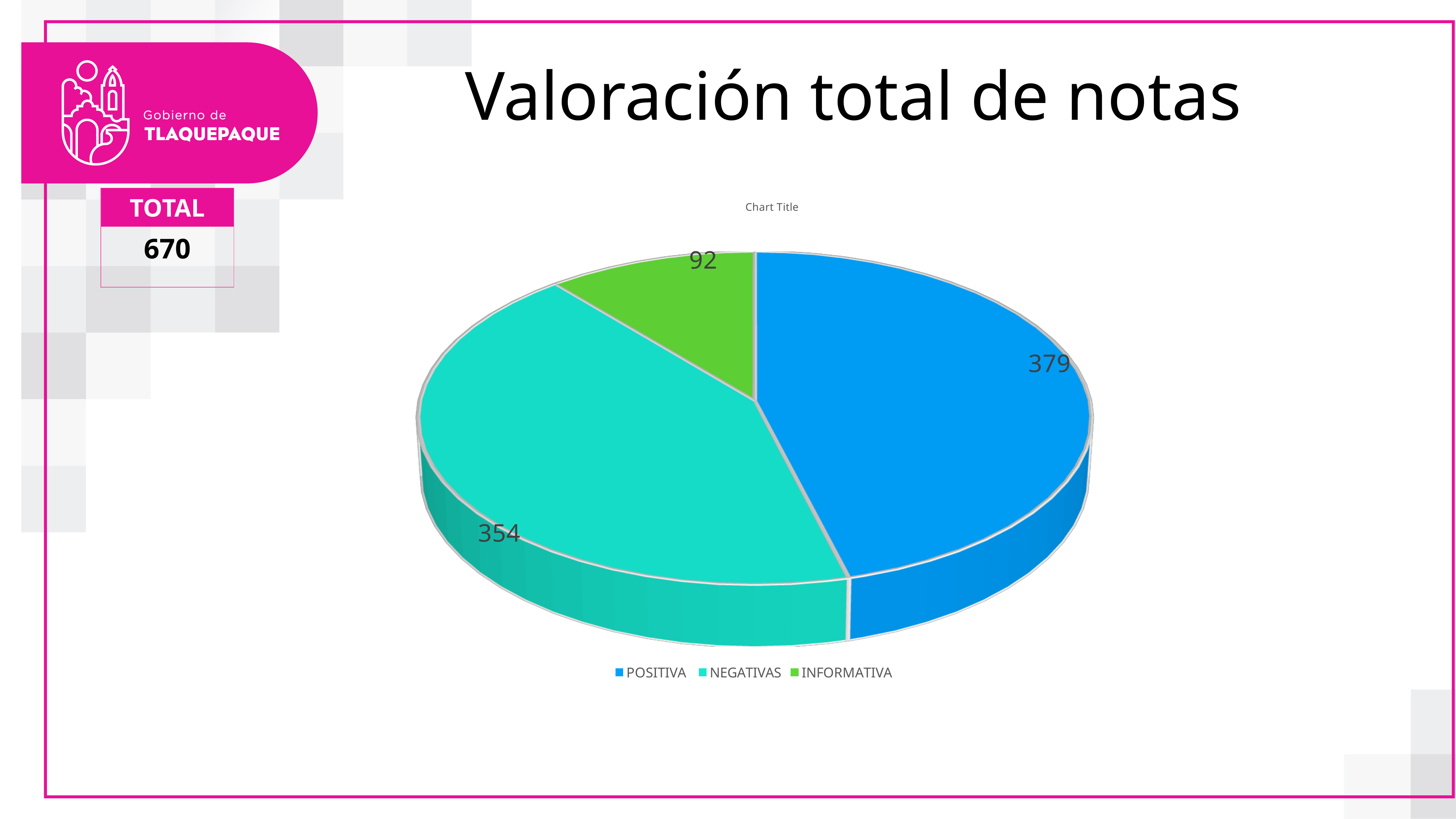
How many entries does the chart legend list? 3 What is the value for POSITIVA in the pie chart? 379 Which category has the smallest slice in the pie chart? INFORMATIVA How many slices does the pie chart have? 3 What is the value for INFORMATIVA in the pie chart? 92 What is the value for NEGATIVAS in the pie chart? 354 What is the difference between the POSITIVA and NEGATIVAS values? 25 What kind of chart is shown on the slide? Pie chart Which category has the largest slice in the pie chart? POSITIVA What is the difference between the NEGATIVAS and INFORMATIVA values? 262 Which is larger, the value for NEGATIVAS or the value for INFORMATIVA? NEGATIVAS What colour is the POSITIVA slice in the pie chart? Blue